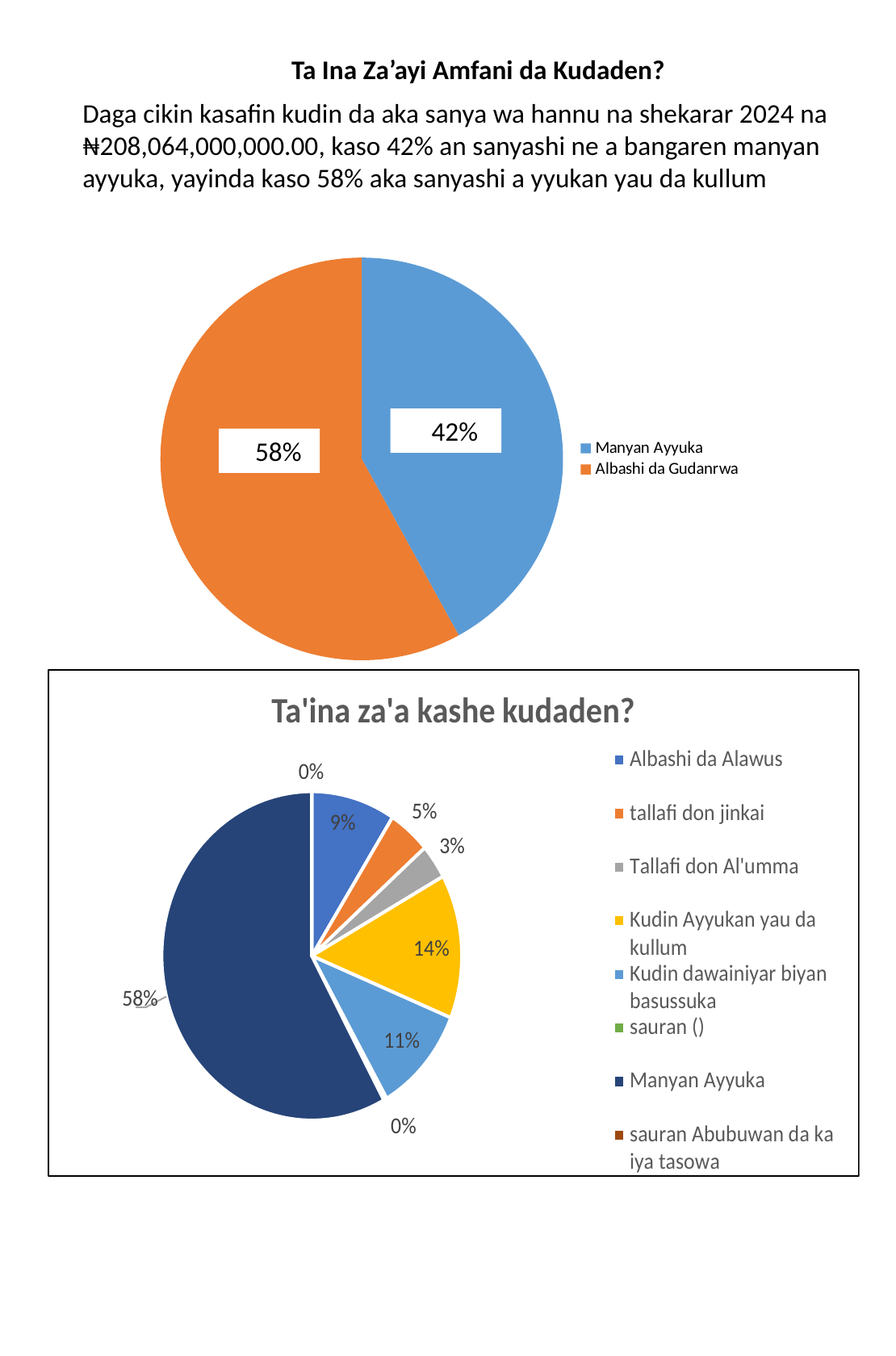
How many categories does the legend of the top pie chart list? 2 In the chart titled "Ta'ina za'a kashe kudaden?", which category has the largest share? Manyan Ayyuka In the chart titled "Ta'ina za'a kashe kudaden?", what is the difference between the shares of Kudin Ayyukan yau da kullum and tallafi don jinkai? 9% In the chart titled "Ta'ina za'a kashe kudaden?", what percentage is shown for Albashi da Alawus? 9% In the chart titled "Ta'ina za'a kashe kudaden?", what percentage is shown for Kudin Ayyukan yau da kullum? 14% What is the title of the bottom chart? Ta'ina za'a kashe kudaden? In the top pie chart, what percentage is shown for Albashi da Gudanrwa? 58% In the top pie chart, what percentage is shown for Manyan Ayyuka? 42% In the top pie chart, which category has the larger share? Albashi da Gudanrwa In the chart titled "Ta'ina za'a kashe kudaden?", what percentage is shown for Kudin dawainiyar biyan basussuka? 11% In the chart titled "Ta'ina za'a kashe kudaden?", how many categories does the legend list? 8 What kind of chart is the top chart on the slide? Pie chart